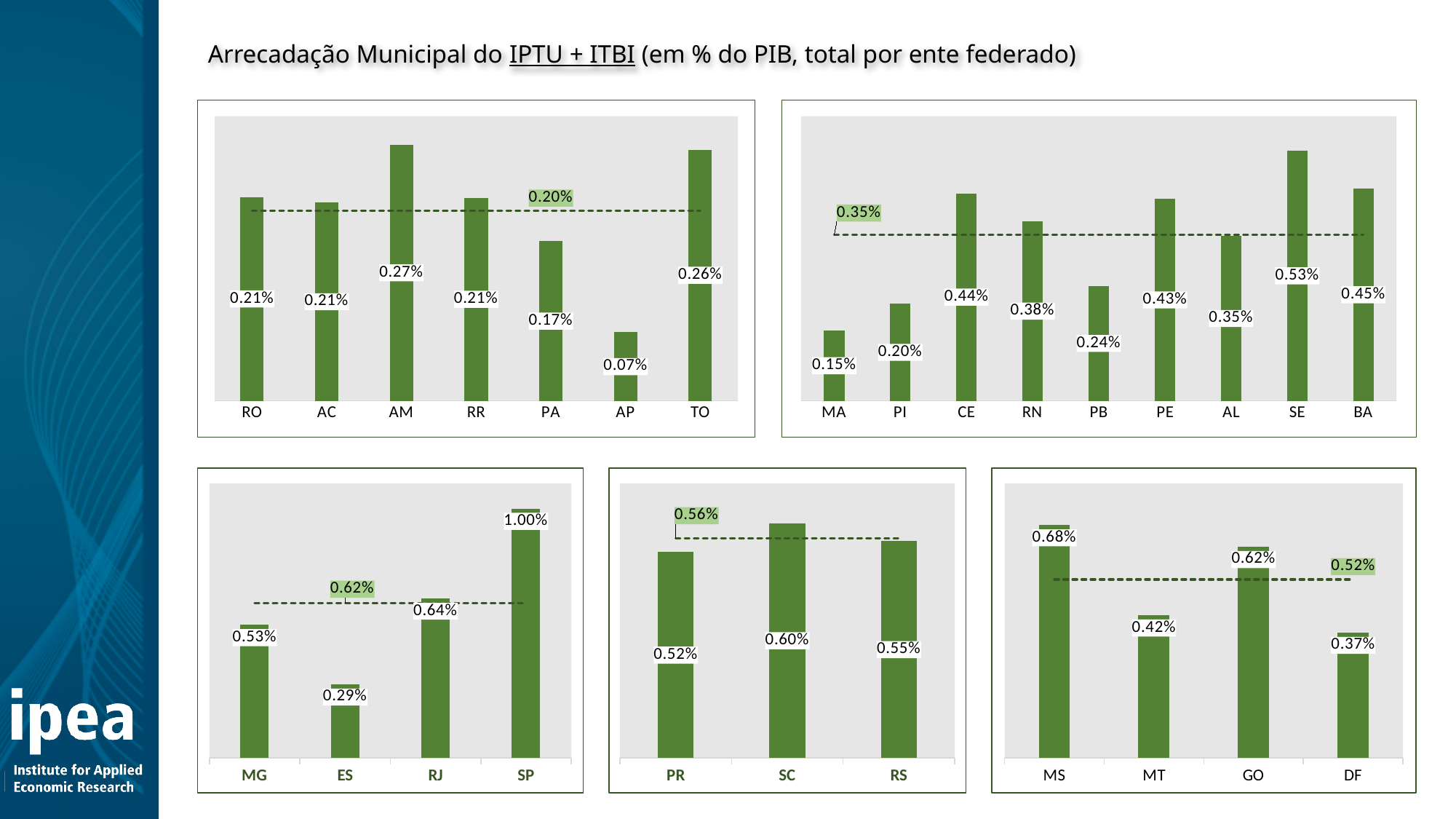
In the top-right chart (MA to BA), which state has the highest value? SE In the top-right chart (MA to BA), how many states are shown? 9 In the top-right chart (MA to BA), what is the value for RN? 0.38% In the top-left chart (RO to TO), which state has the lowest value? AP In the bottom-left chart (MG to SP), which is larger, the value for MG or the value for RJ? RJ In the top-right chart (MA to BA), what is the difference between the values for SE and MA? 0.38% In the top-left chart (RO to TO), what is the value of the dashed reference line? 0.20% In the bottom-right chart (MS to DF), what is the difference between the values for MS and DF? 0.31% In the top-left chart (RO to TO), what is the value for AM? 0.27% What kind of chart is used on this slide? Bar chart In the bottom-left chart (MG to SP), what is the value for SP? 1.00% In the bottom-middle chart (PR to RS), what is the value for SC? 0.60%